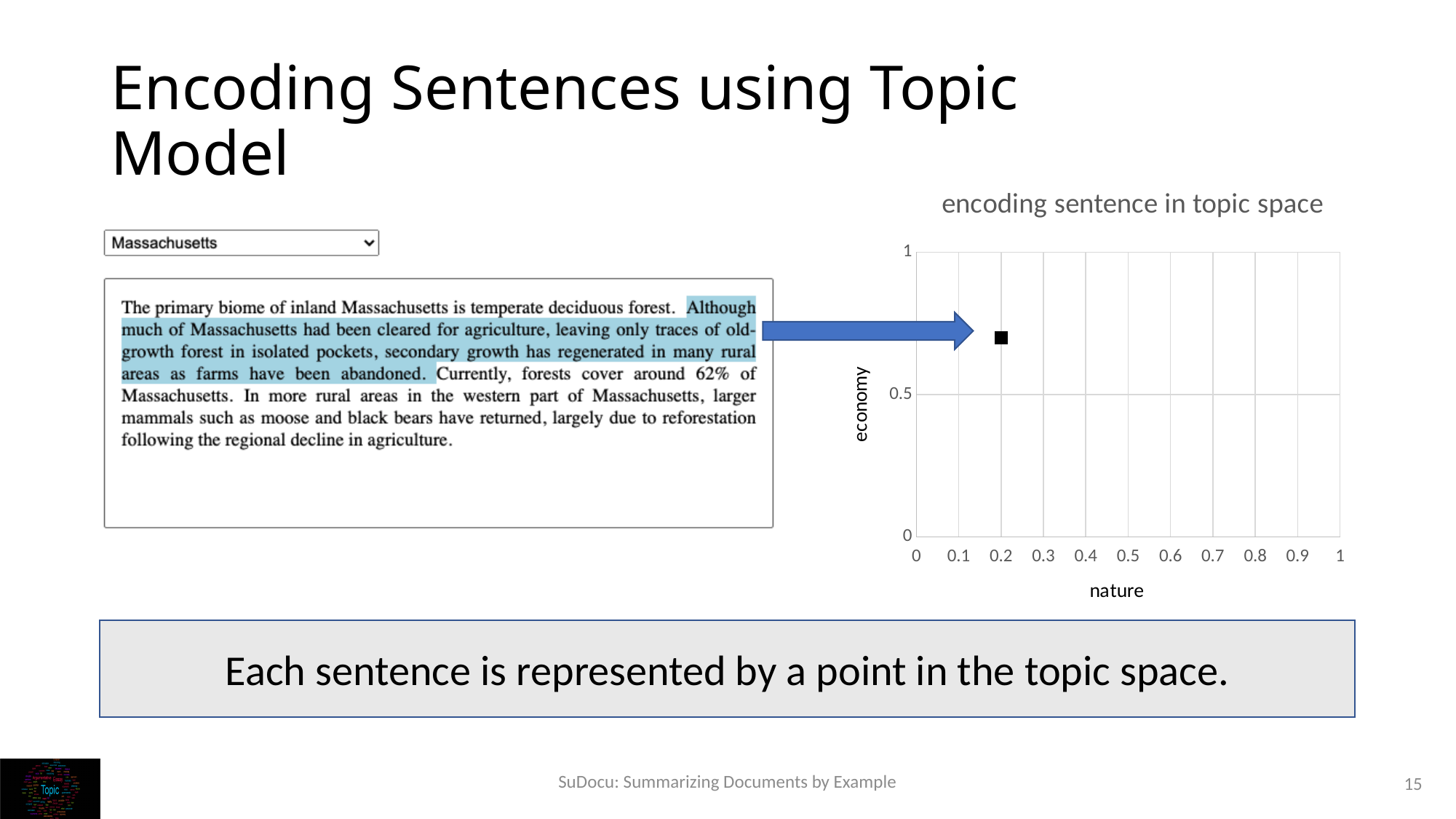
What is the title of the chart? encoding sentence in topic space Is the economy value of the plotted point greater or less than 0.5? greater Is the nature value of the plotted point greater or less than 0.5? less What is the nature value of the plotted point? 0.2 What is the maximum value shown on the economy axis? 1 What is the label of the x axis of the chart? nature What kind of chart is shown on the slide? scatter plot How many data points are plotted in the chart? 1